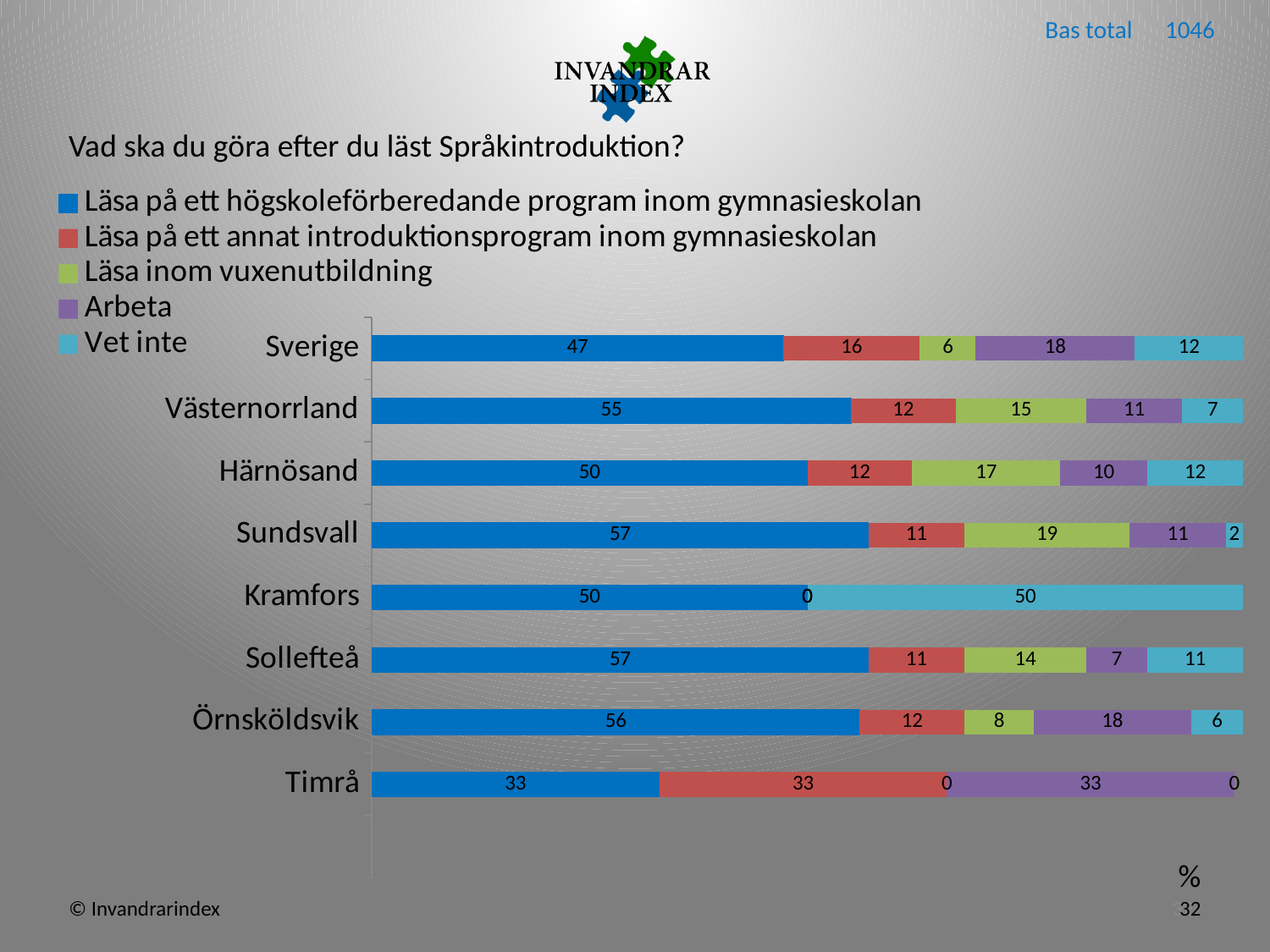
Which has the larger value for 'Läsa inom vuxenutbildning', Härnösand or Sollefteå? Härnösand How many series does the legend list? 5 How many categories (regions) are shown on the chart? 8 What is the value for Örnsköldsvik in the series 'Arbeta'? 18 What kind of chart is shown on the slide? bar chart What is the value for Kramfors in the series 'Vet inte'? 50 What is the value for Timrå in the series 'Läsa på ett annat introduktionsprogram inom gymnasieskolan'? 33 Which region has the lowest value for 'Läsa på ett högskoleförberedande program inom gymnasieskolan'? Timrå What is the difference between the 'Arbeta' values for Sverige and Västernorrland? 7 What question is the chart about, as stated in the title above the legend? Vad ska du göra efter du läst Språkintroduktion? What is the value for Sverige in the series 'Läsa på ett högskoleförberedande program inom gymnasieskolan'? 47 What is the value for Sundsvall in the series 'Läsa inom vuxenutbildning'? 19